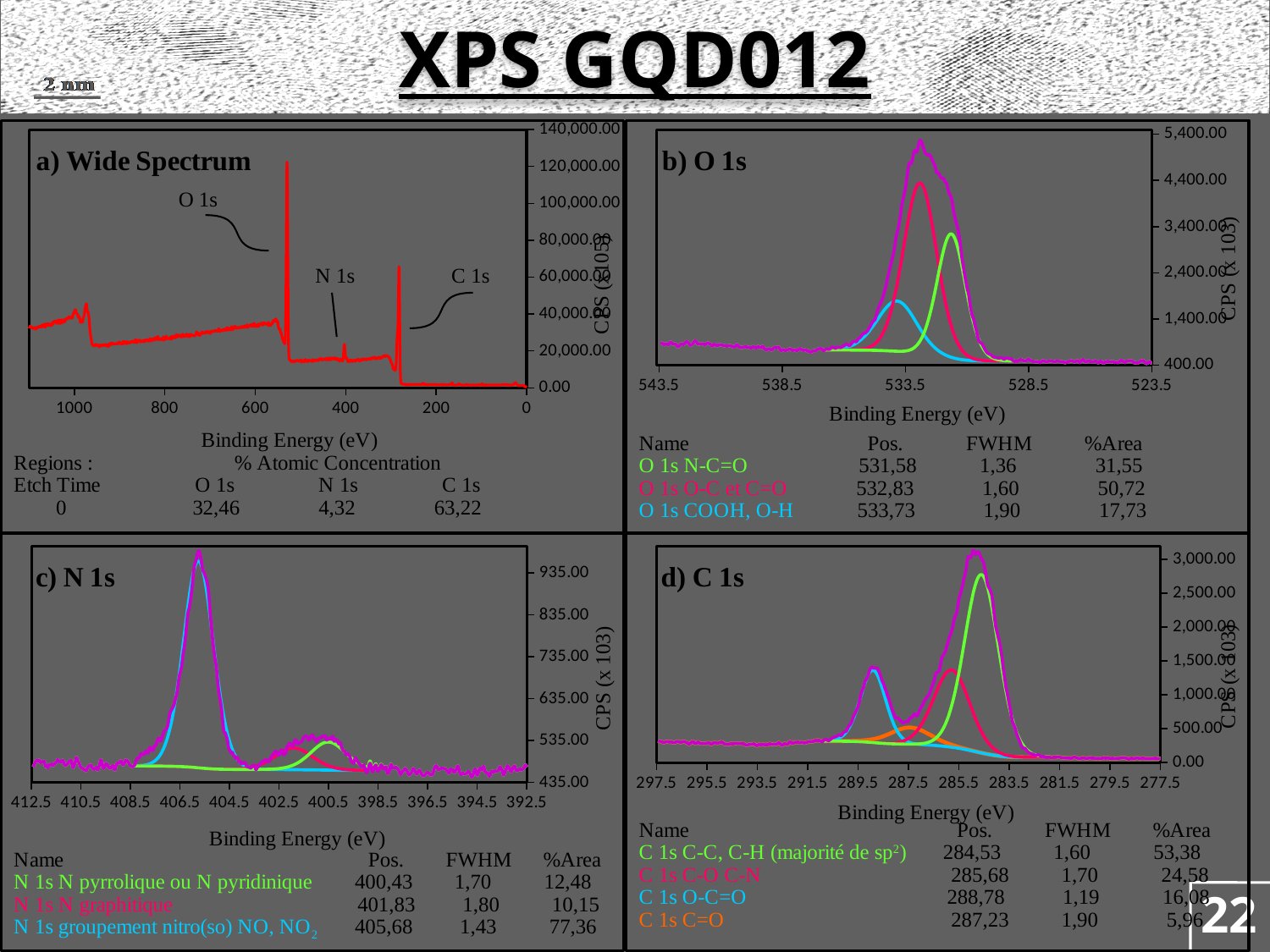
In the b) O 1s table, which component has the highest %Area? O 1s O-C et C=O In the a) Wide Spectrum chart, is the height of the O 1s peak greater or less than 100,000.00 CPS? greater In the d) C 1s table, how many components are listed? 4 In the d) C 1s table, which has the larger FWHM: C 1s C=O or C 1s O-C=O? C 1s C=O What kind of chart is the a) Wide Spectrum chart? line chart In the d) C 1s table, what is the %Area of the C 1s C-C, C-H component? 53,38 In the a) Wide Spectrum table, which region has the lowest % Atomic Concentration? N 1s In the a) Wide Spectrum table, what is the % Atomic Concentration of C 1s? 63,22 In the b) O 1s table, what is the Pos. of the O 1s N-C=O component? 531,58 In the c) N 1s table, which component has the lowest %Area? N 1s N graphitique In the a) Wide Spectrum table, what is the difference between the % Atomic Concentration of C 1s and O 1s? 30,76 In the c) N 1s table, what is the %Area of the N 1s groupement nitro(so) NO, NO2 component? 77,36